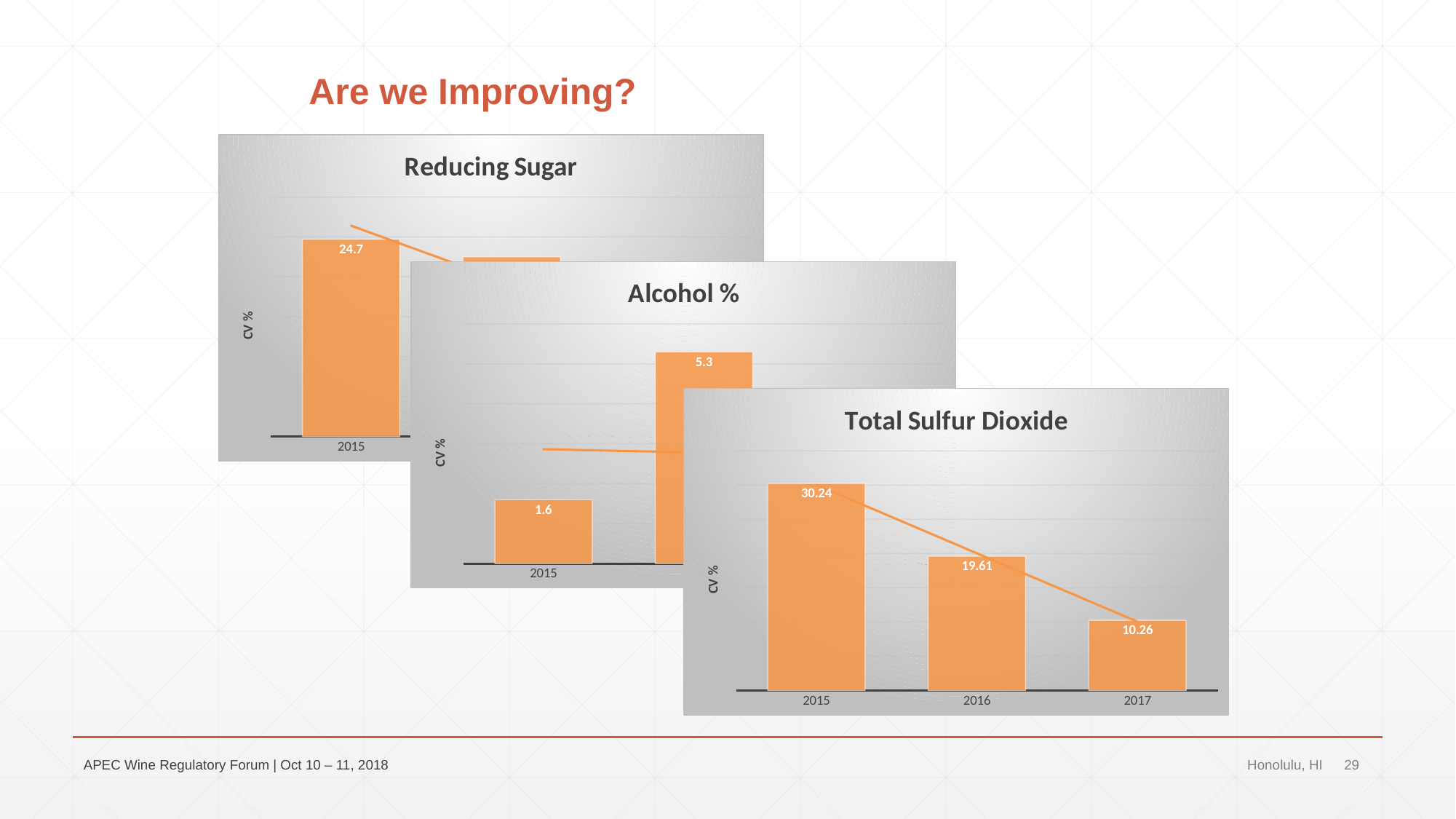
What is the y-axis label on the Total Sulfur Dioxide chart? CV % In the Total Sulfur Dioxide chart, what is the difference between the 2015 and 2017 values? 19.98 In the Alcohol % chart, what is the value for 2015? 1.6 In the Total Sulfur Dioxide chart, what is the value for 2016? 19.61 In the Total Sulfur Dioxide chart, what is the value for 2017? 10.26 In the Total Sulfur Dioxide chart, do the values rise or fall from 2015 to 2017? fall In the Reducing Sugar chart, what is the value for 2015? 24.7 What kind of chart is the Total Sulfur Dioxide chart? bar chart In the Total Sulfur Dioxide chart, what is the value for 2015? 30.24 In the Total Sulfur Dioxide chart, which year has the highest value? 2015 How many years are shown on the x axis of the Total Sulfur Dioxide chart? 3 In the Total Sulfur Dioxide chart, which year has the lowest value? 2017